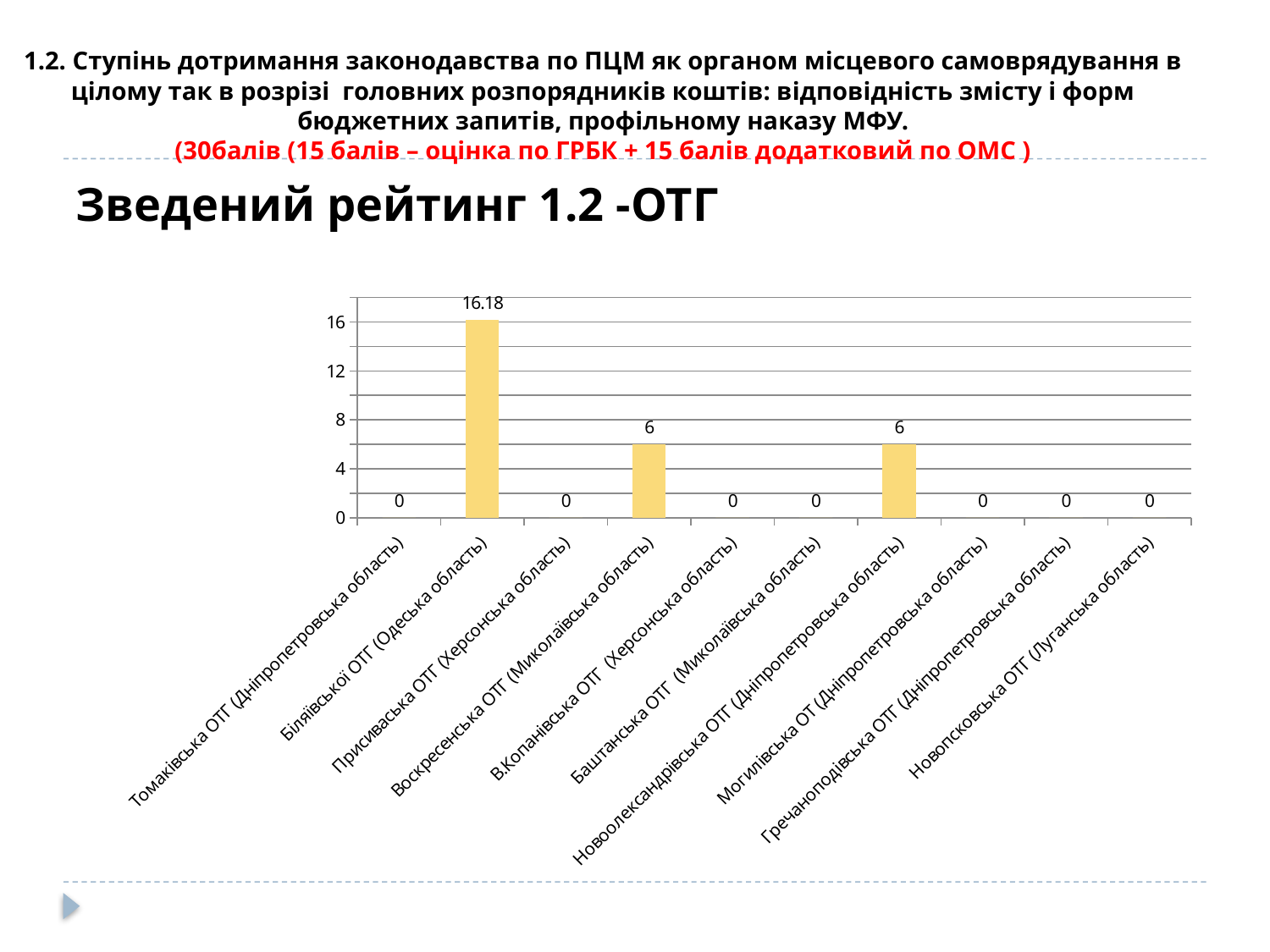
How many categories have a value of 0? 7 What is the value for Біляївської ОТГ (Одеська область)? 16.18 What is the value for Томаківська ОТГ (Дніпропетровська область)? 0 How many categories are shown on the x axis? 10 What is the title of the chart? Зведений рейтинг 1.2 -ОТГ Is the value for Біляївської ОТГ (Одеська область) greater or less than 12? greater What kind of chart is shown on the slide? bar chart What is the difference between the values for Біляївської ОТГ (Одеська область) and Воскресенська ОТГ (Миколаївська область)? 10.18 What is the value for Воскресенська ОТГ (Миколаївська область)? 6 What is the value for Новоолександрівська ОТГ (Дніпропетровська область)? 6 Which category has the highest value? Біляївської ОТГ (Одеська область) Which is larger, the value for Новоолександрівська ОТГ (Дніпропетровська область) or the value for Баштанська ОТГ (Миколаївська область)? Новоолександрівська ОТГ (Дніпропетровська область)